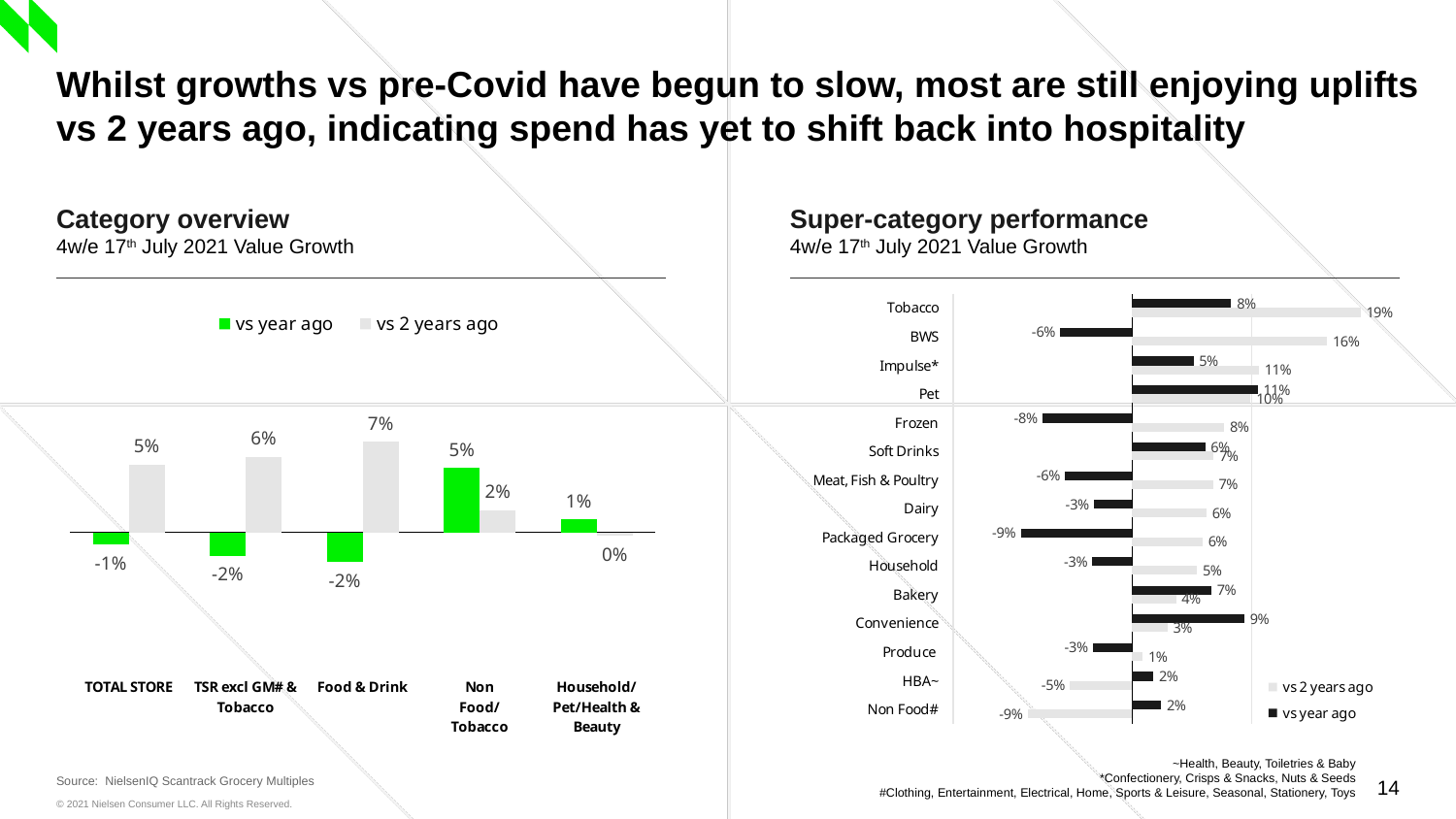
In the Super-category performance chart, what is the vs year ago value for Packaged Grocery? -9% In the Category overview chart, what is the vs 2 years ago value for TSR excl GM# & Tobacco? 6% In the Super-category performance chart, which super-category has the lowest vs 2 years ago value? Non Food# In the Category overview chart, how many categories are shown? 5 In the Category overview chart, what is the vs year ago value for Food & Drink? -2% In the Category overview chart, what is the difference between the vs 2 years ago and vs year ago values for TOTAL STORE? 6 percentage points In the Super-category performance chart, what is the vs 2 years ago value for Tobacco? 19% In the Super-category performance chart, how many super-categories are listed? 15 What type of chart is the Super-category performance chart? Bar chart How many series does the legend of the Super-category performance chart list? 2 In the Super-category performance chart, which is larger: the vs year ago value for Convenience or for Bakery? Convenience In the Category overview chart, which category has the highest vs 2 years ago value? Food & Drink